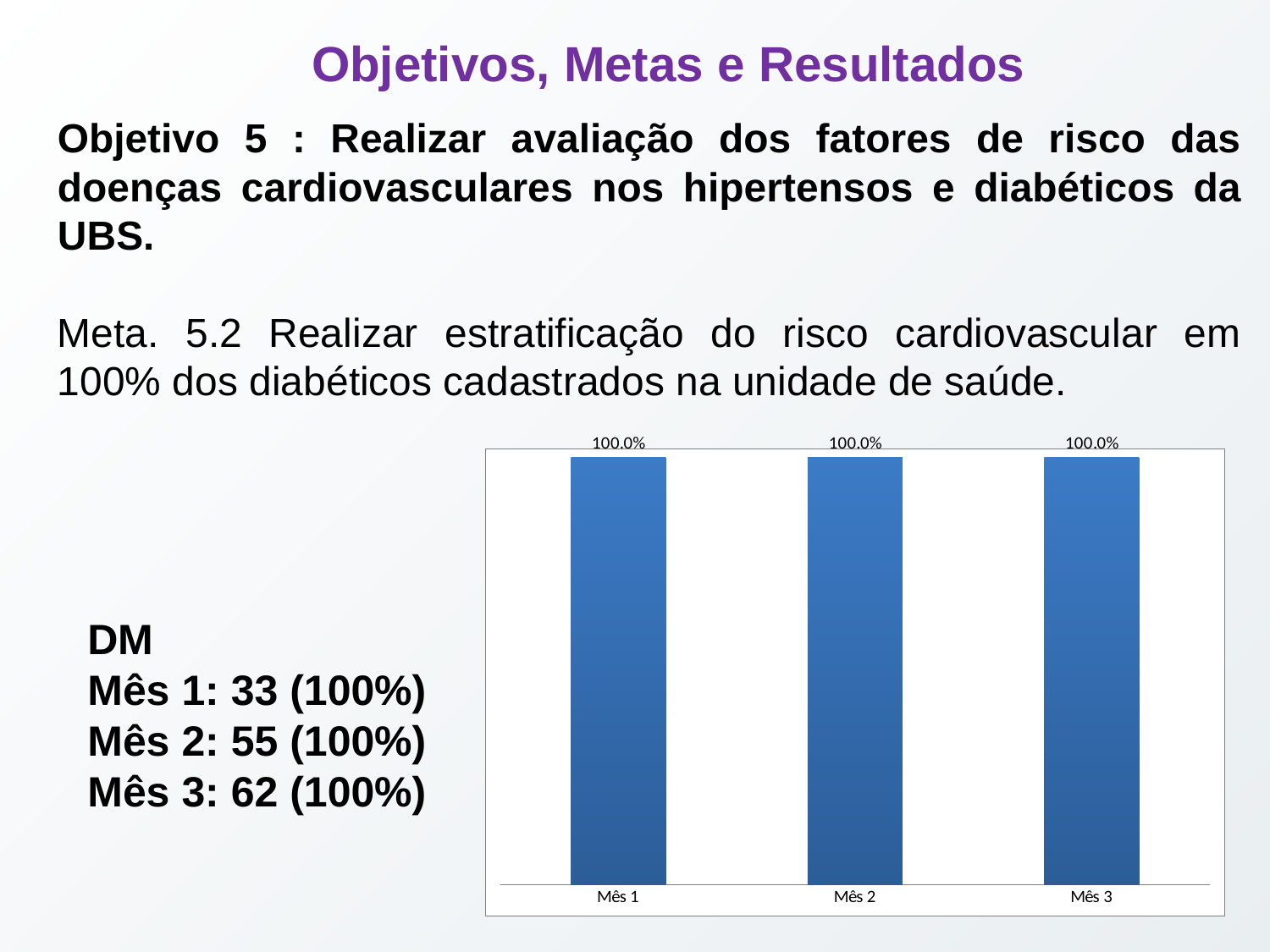
What is the value shown for Mês 2 in the bar chart? 100.0% What are the category labels on the x axis of the chart? Mês 1, Mês 2, Mês 3 What is the value shown for Mês 1 in the bar chart? 100.0% Do the values in the chart rise, fall, or stay the same from Mês 1 to Mês 3? Stay the same What colour are the bars in the chart? Blue What kind of chart is shown on the slide? Bar chart What is the value shown for Mês 3 in the bar chart? 100.0% How many categories are plotted in the bar chart? 3 Is the value for Mês 2 in the chart the same as the value for Mês 3? Yes What is the difference between the values for Mês 3 and Mês 1 in the chart? 0.0%